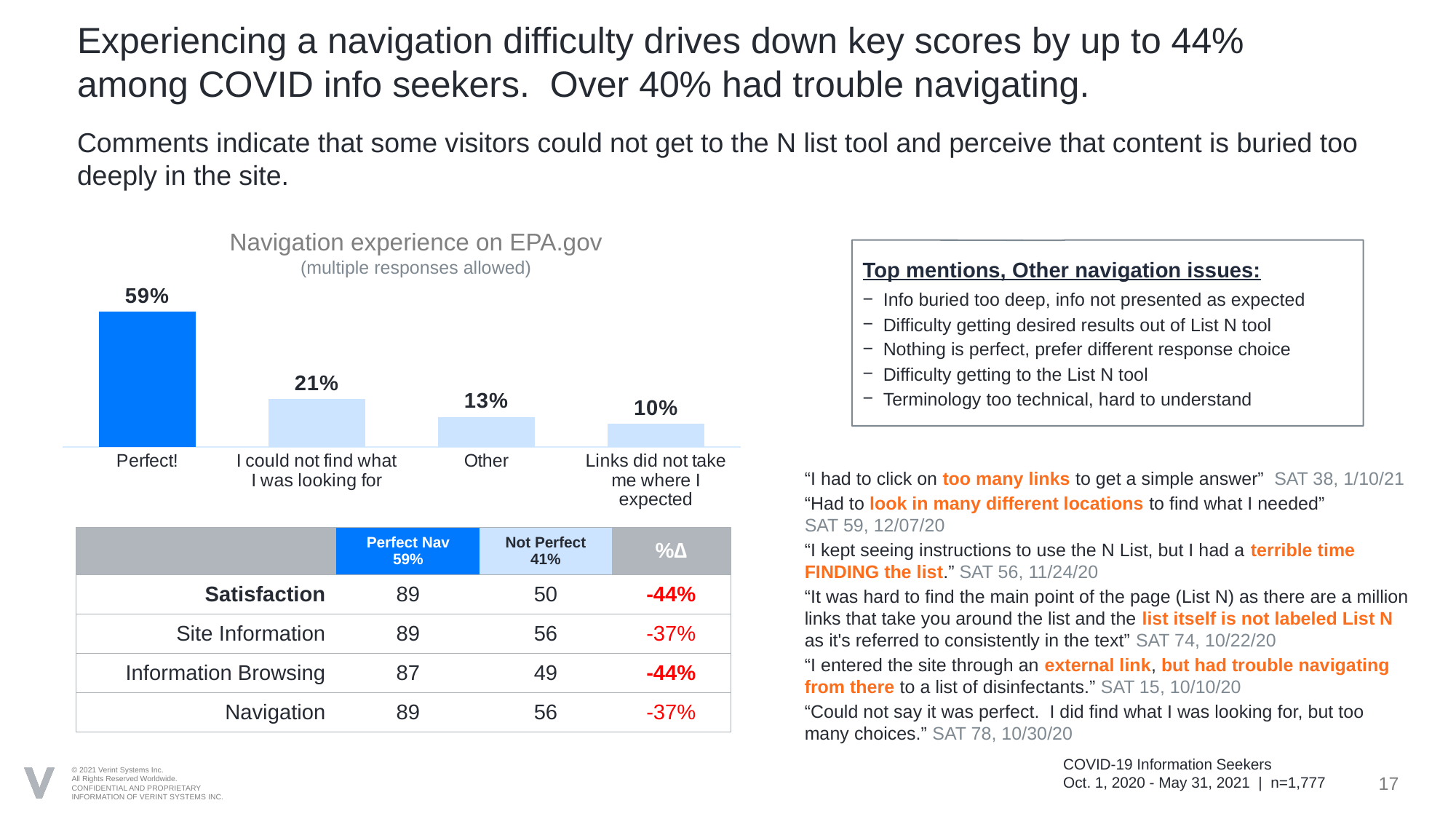
What is the value for "Links did not take me where I expected" in the Navigation experience on EPA.gov chart? 10% Which category has the lowest value in the Navigation experience on EPA.gov chart? Links did not take me where I expected How many categories are shown in the Navigation experience on EPA.gov chart? 4 What is the subtitle shown under the title of the Navigation experience on EPA.gov chart? (multiple responses allowed) What is the value for "Other" in the Navigation experience on EPA.gov chart? 13% What kind of chart is the Navigation experience on EPA.gov chart? Bar chart In the Navigation experience on EPA.gov chart, which is larger: "Other" or "Links did not take me where I expected"? Other What is the value for "I could not find what I was looking for" in the Navigation experience on EPA.gov chart? 21% What is the value for "Perfect!" in the Navigation experience on EPA.gov chart? 59% Do the values in the Navigation experience on EPA.gov chart rise or fall from left to right? Fall Which category has the highest value in the Navigation experience on EPA.gov chart? Perfect! In the Navigation experience on EPA.gov chart, what is the difference between the values for "Perfect!" and "I could not find what I was looking for"? 38%